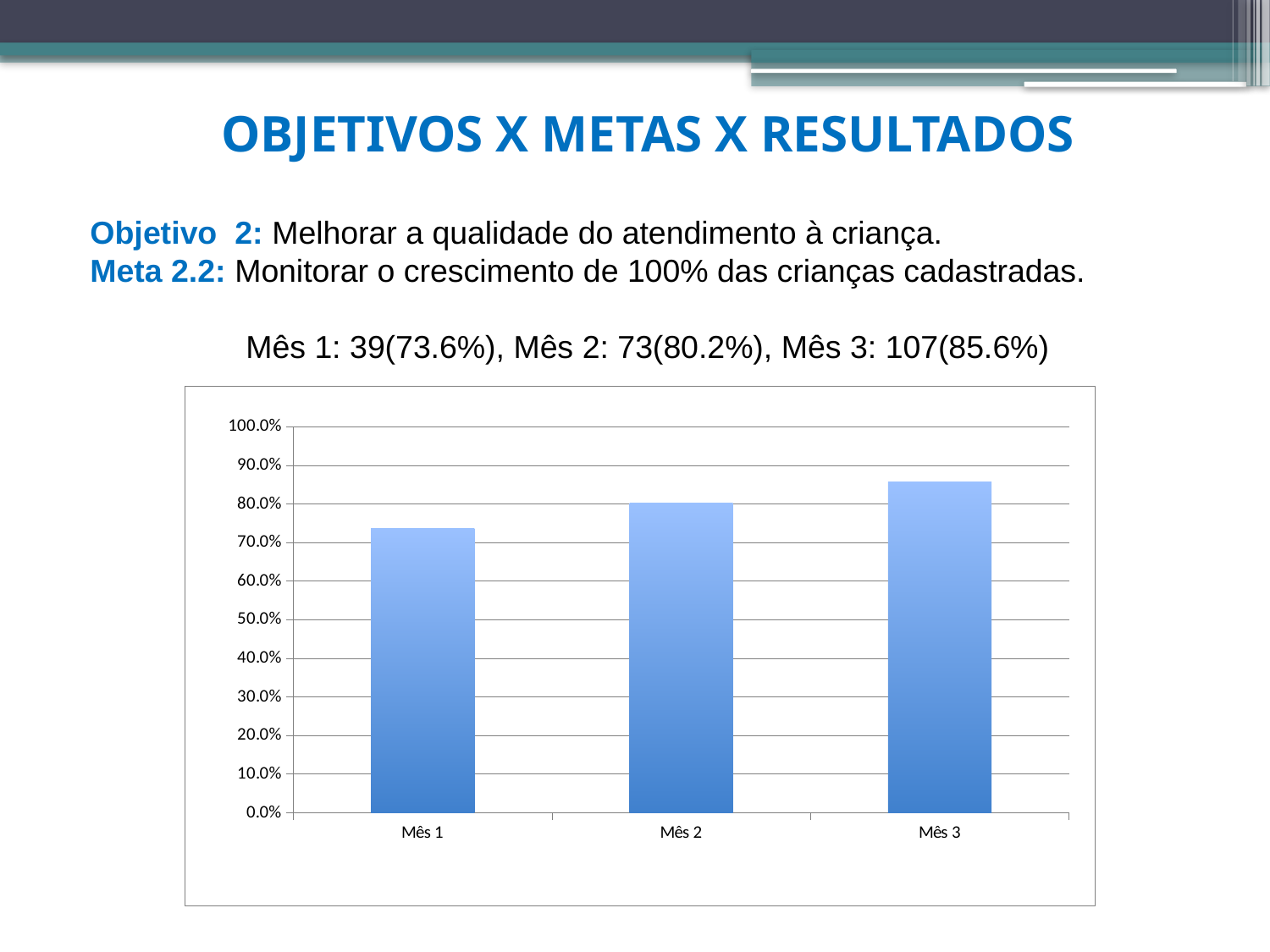
What kind of chart is shown on the slide? bar chart Do the values rise or fall from Mês 1 to Mês 3? rise Which month has the highest value in the bar chart? Mês 3 How many categories are shown on the x axis of the bar chart? 3 Which month has the lowest value in the bar chart? Mês 1 What is the difference between the values for Mês 3 and Mês 1? 12.0% Which is larger, the value for Mês 2 or the value for Mês 3? Mês 3 What is the difference between the values for Mês 2 and Mês 1? 6.6% What is the value for Mês 3 in the bar chart? 85.6% Is the value for Mês 1 greater or less than 70.0%? greater What is the value for Mês 2 in the bar chart? 80.2% What is the value for Mês 1 in the bar chart? 73.6%